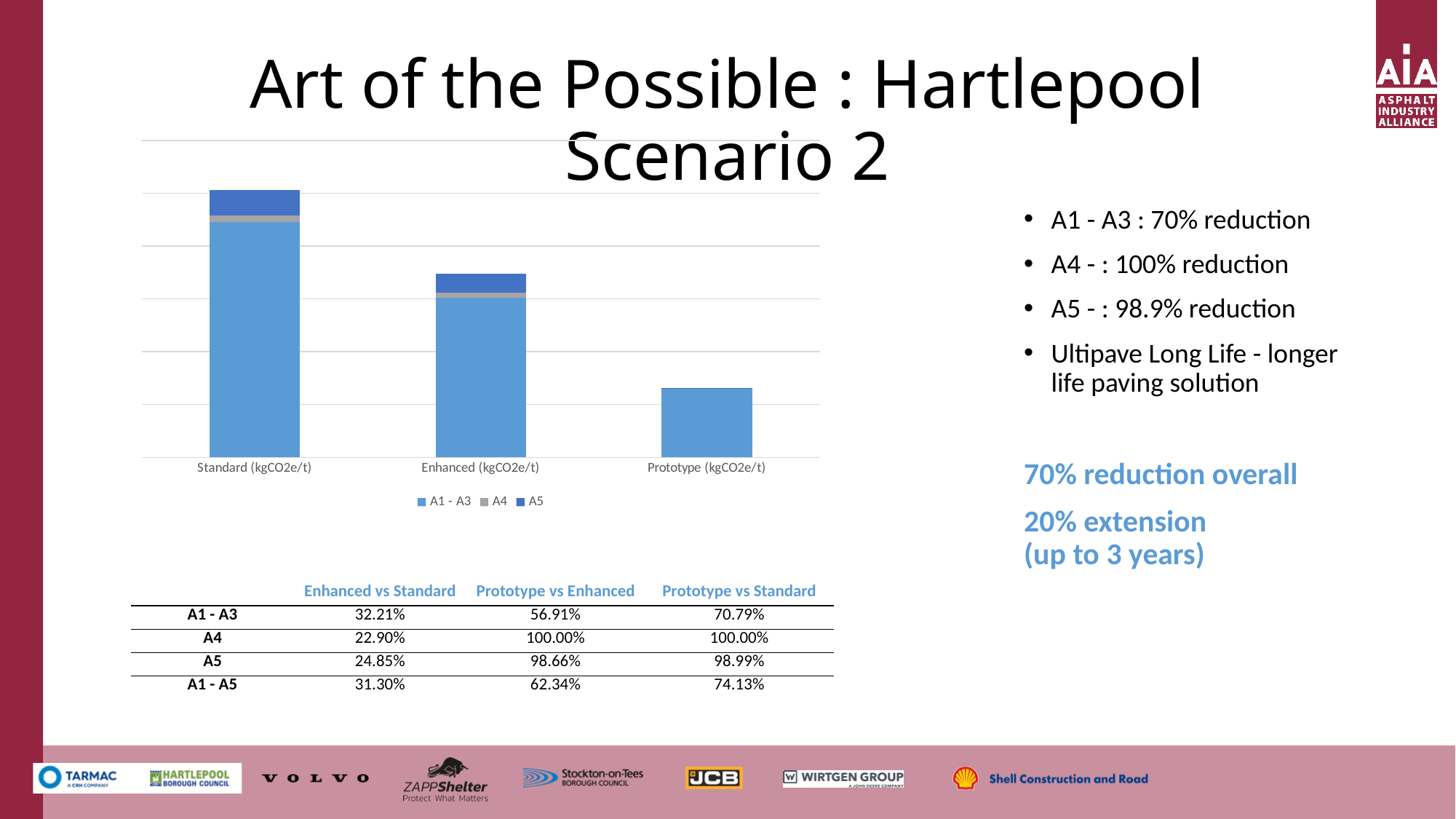
Which stacked bar is taller, Standard (kgCO2e/t) or Enhanced (kgCO2e/t)? Standard (kgCO2e/t) Which category has the shortest stacked bar in the chart? Prototype (kgCO2e/t) How many series does the chart legend list? 3 What kind of chart is shown on the slide? Stacked bar chart Which series is the smallest segment of the Enhanced (kgCO2e/t) bar? A4 What are the three series names listed in the chart legend? A1 - A3, A4, A5 Which stacked bar is taller, Enhanced (kgCO2e/t) or Prototype (kgCO2e/t)? Enhanced (kgCO2e/t) Do the stacked bar totals rise or fall from left to right across the x axis? Fall Which category has the tallest stacked bar in the chart? Standard (kgCO2e/t) What colour represents the A4 series in the chart? Grey Which series makes up the largest segment of the Standard (kgCO2e/t) bar? A1 - A3 How many categories are plotted along the x axis of the chart? 3